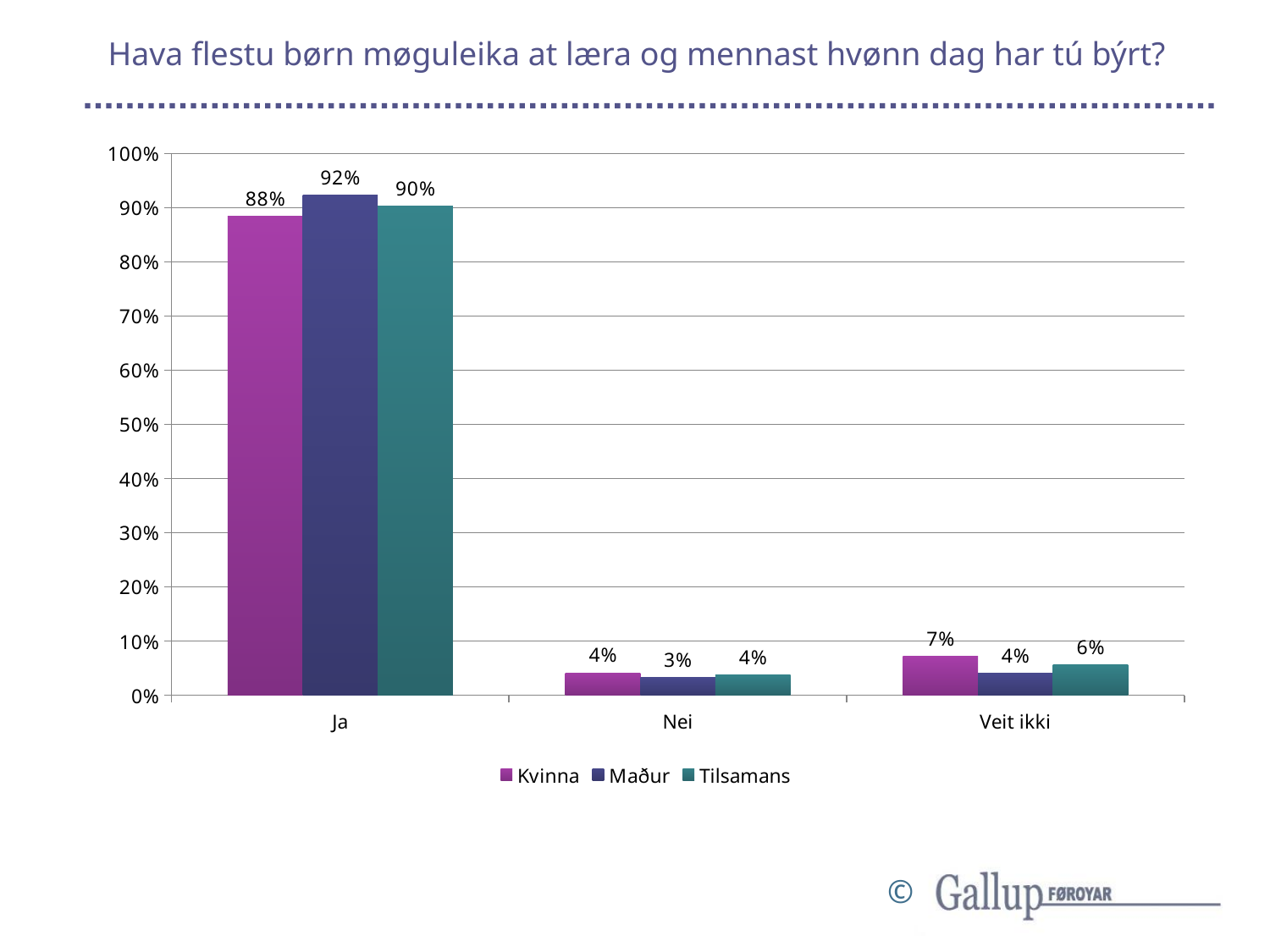
How many series does the legend list? 3 Which is larger in the Veit ikki category: Kvinna or Maður? Kvinna What kind of chart is shown on the slide? bar chart Which category has the highest value for Tilsamans? Ja Is the value for Tilsamans in the Ja category greater or less than 80%? greater What is the difference between the Maður and Kvinna values in the Ja category? 4% Which category has the lowest value for Kvinna? Nei What is the value for Kvinna in the Ja category? 88% What is the value for Maður in the Ja category? 92% What is the value for Tilsamans in the Veit ikki category? 6% How many categories are shown on the x axis? 3 What is the value for Maður in the Nei category? 3%